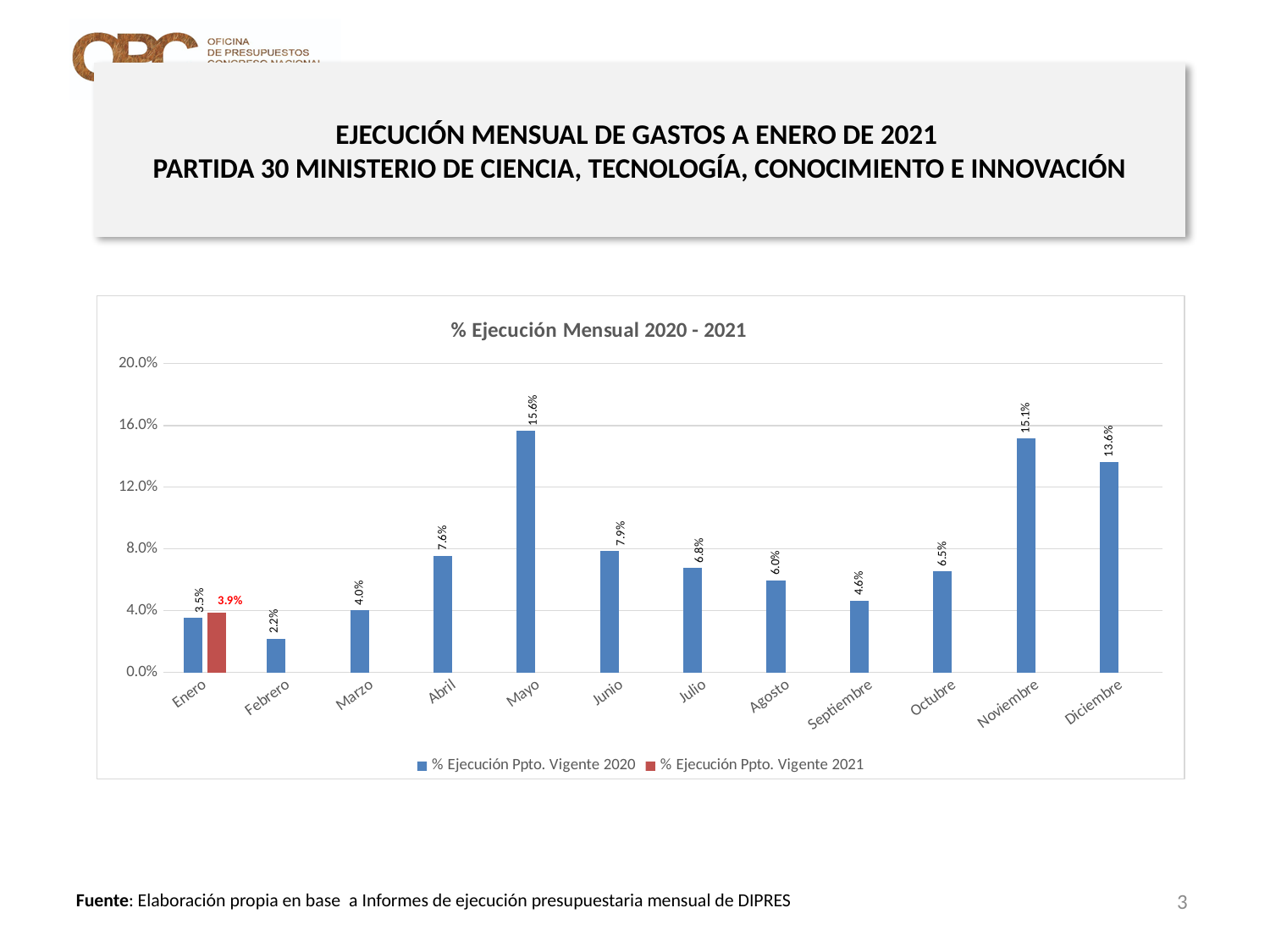
Is the value for Junio in the 2020 series greater or less than 8.0%? less How many months are shown on the x axis? 12 Which is larger for Enero: the 2020 value or the 2021 value? 2021 (3.9%) Which month has the lowest value in the % Ejecución Ppto. Vigente 2020 series? Febrero What is the title of the chart? % Ejecución Mensual 2020 - 2021 What is the value for Mayo in the % Ejecución Ppto. Vigente 2020 series? 15.6% What is the difference between the Noviembre and Diciembre values in the % Ejecución Ppto. Vigente 2020 series? 1.5% How many series does the legend list? 2 What is the value for Septiembre in the % Ejecución Ppto. Vigente 2020 series? 4.6% Which month has the highest value in the % Ejecución Ppto. Vigente 2020 series? Mayo What kind of chart is shown on the slide? Bar chart What is the value for Enero in the % Ejecución Ppto. Vigente 2021 series? 3.9%